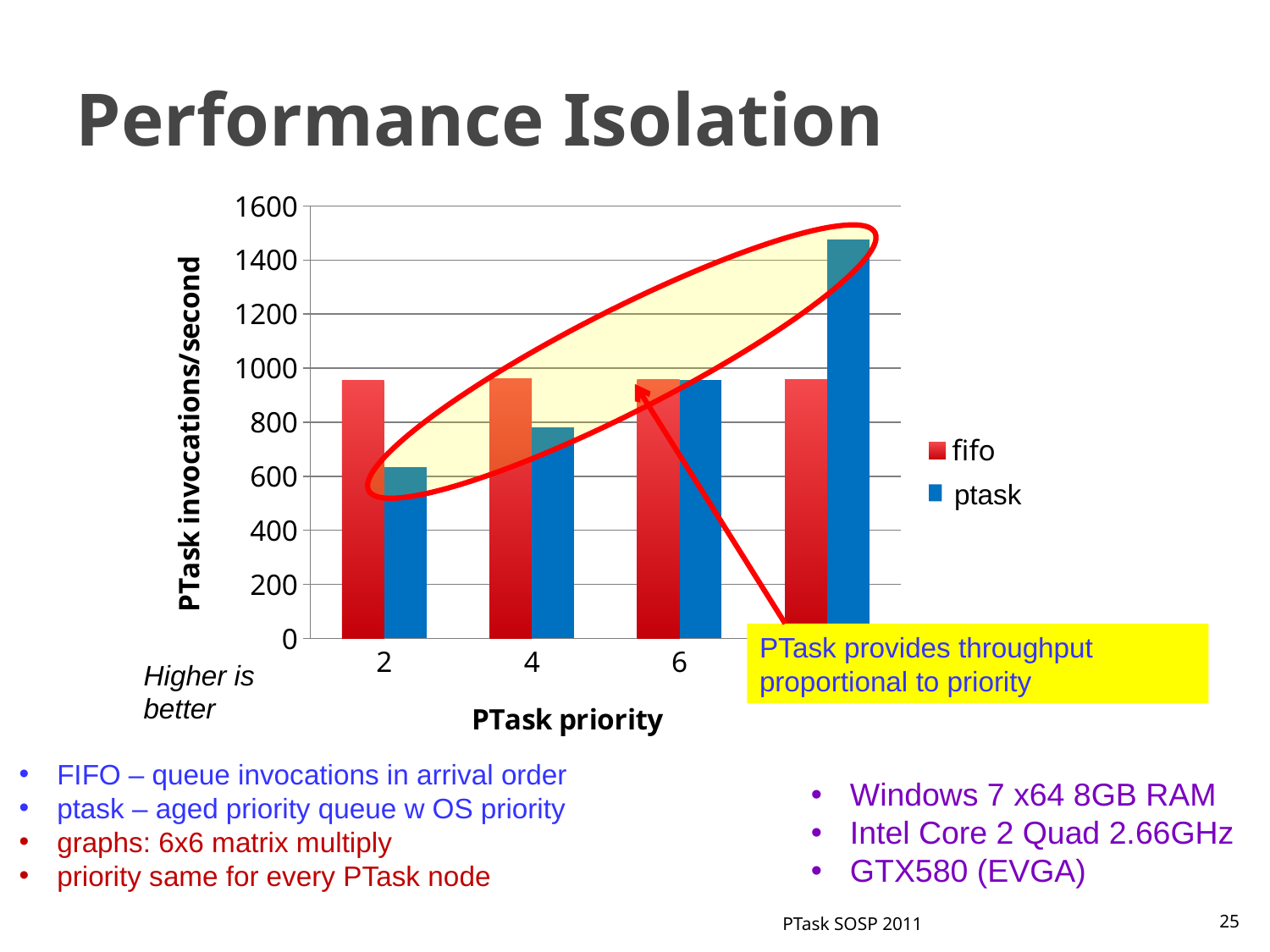
Which series are listed in the legend? fifo and ptask How many series does the legend list? 2 At PTask priority 2, which series has the larger value, fifo or ptask? fifo Which series reaches the highest value anywhere on the chart? ptask Is the ptask value at PTask priority 2 greater or less than 800? less What kind of chart is shown on the slide? bar chart What is the title of the y axis? PTask invocations/second Is the fifo value at PTask priority 2 greater or less than 800? greater At PTask priority 4, which series has the larger value, fifo or ptask? fifo How many groups of bars are plotted along the x axis? 4 Do the ptask values rise or fall as PTask priority increases along the x axis? rise Is the ptask value at PTask priority 4 greater or less than 1000? less